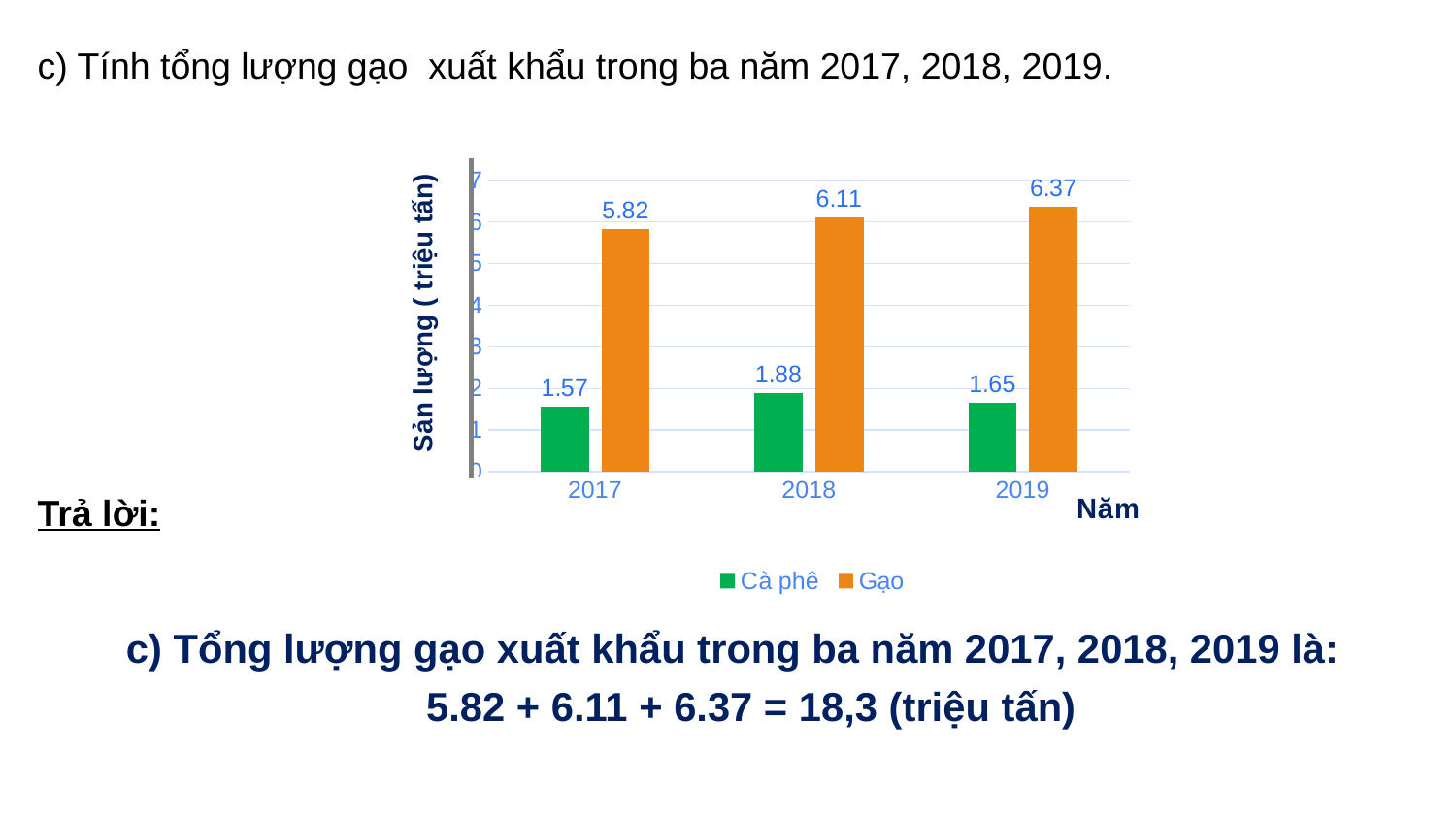
What kind of chart is shown on the slide? bar chart Is the value for Gạo in 2017 greater or less than 5? greater What is the value for Gạo in 2018? 6.11 How many series does the legend list? 2 What is the value for Cà phê in 2019? 1.65 In which year is the Cà phê value lowest? 2017 What is the label of the y axis? Sản lượng ( triệu tấn) Which is larger: Cà phê in 2018 or Cà phê in 2019? Cà phê in 2018 What is the value for Cà phê in 2017? 1.57 How many years are shown on the x axis? 3 In which year is the Gạo value highest? 2019 What is the difference between the Gạo values for 2019 and 2017? 0.55